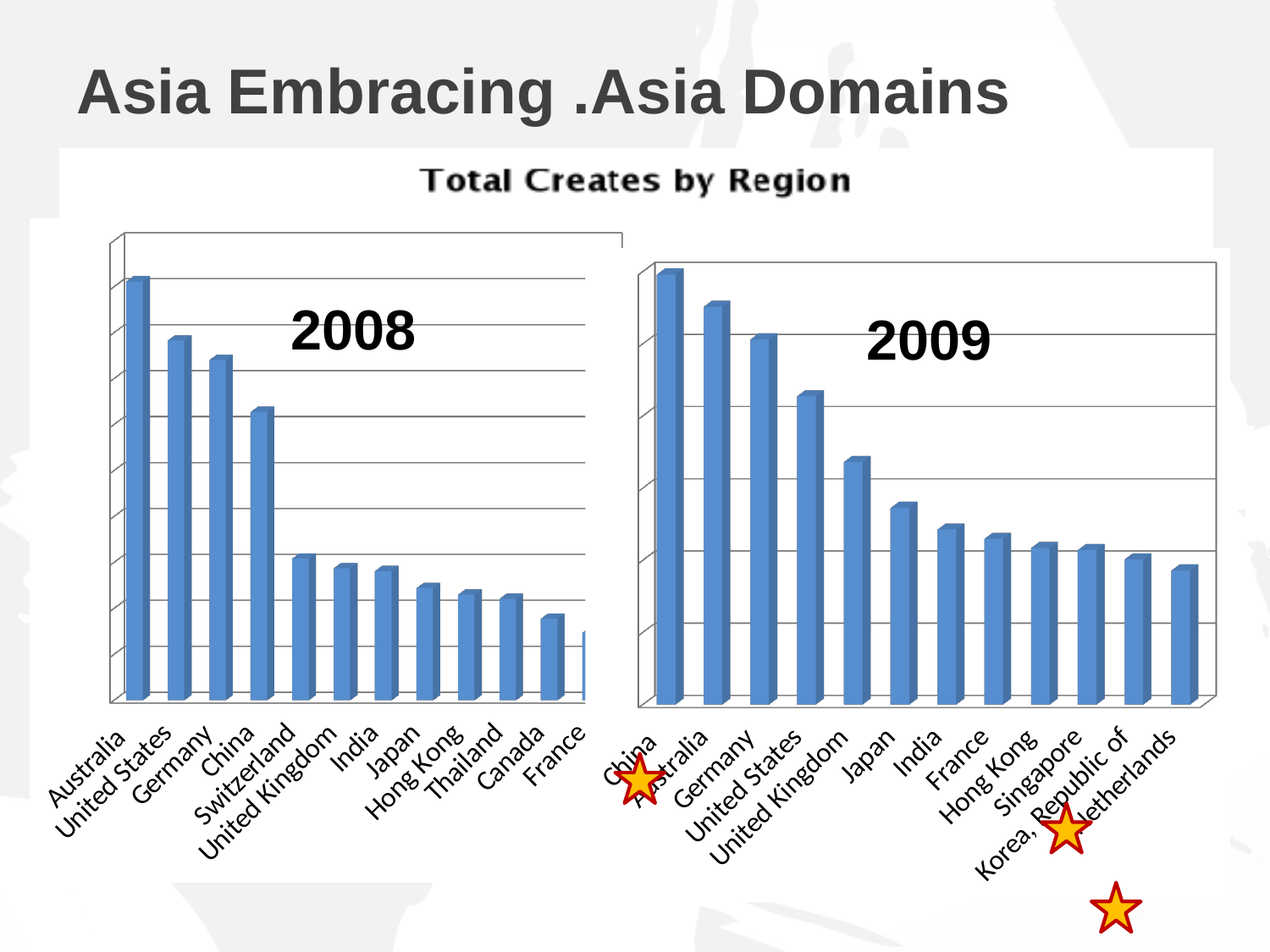
In the 2009 chart, which region has the lowest value? Netherlands In the 2009 chart, do the values rise or fall from left to right? fall In the 2008 chart, which is larger, the value for Germany or the value for China? Germany In the 2009 chart, which region has the highest value? China How many regions are shown in the 2008 chart? 12 How many regions are shown in the 2009 chart? 12 In the 2009 chart, which is larger, the value for United States or the value for United Kingdom? United States In the 2009 chart, which is larger, the value for Australia or the value for Germany? Australia What kind of chart is the 2008 chart? bar chart In the 2008 chart, which region has the highest value? Australia What is the title shown above the two charts? Total Creates by Region In the 2008 chart, which region has the lowest value? France